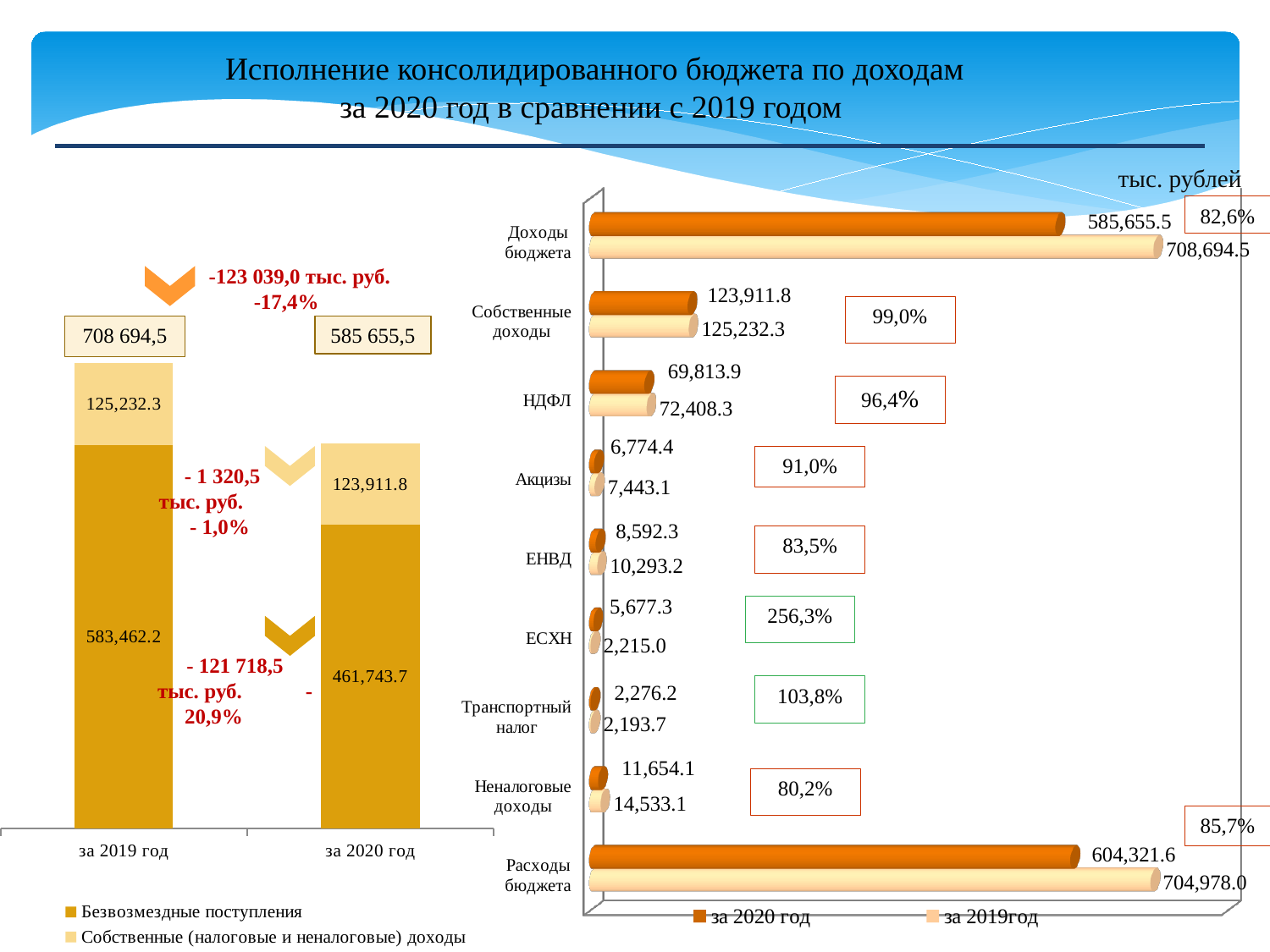
In the left stacked bar chart, what is the value of Собственные (налоговые и неналоговые) доходы for за 2020 год? 123,911.8 In the left stacked bar chart, how many series does the legend list? 2 In the right horizontal bar chart, how many categories are shown on the vertical axis? 9 In the right horizontal bar chart, what is the difference between the за 2019 год and за 2020 год values for ЕНВД? 1,700.9 In the right horizontal bar chart, what is the value for Расходы бюджета for за 2019 год? 704,978.0 In the left stacked bar chart, what is the total of the stacked bar for за 2019 год? 708 694,5 In the right horizontal bar chart, what is the value for НДФЛ for за 2020 год? 69,813.9 In the right horizontal bar chart, what is the value for Неналоговые доходы for за 2020 год? 11,654.1 In the left stacked bar chart, what is the value of Безвозмездные поступления for за 2019 год? 583,462.2 In the right horizontal bar chart, which is larger for ЕСХН: the value for за 2020 год or за 2019 год? за 2020 год In the right horizontal bar chart, which category has the lowest value for за 2019 год? Транспортный налог What type of chart is shown on the right side of the slide? Bar chart